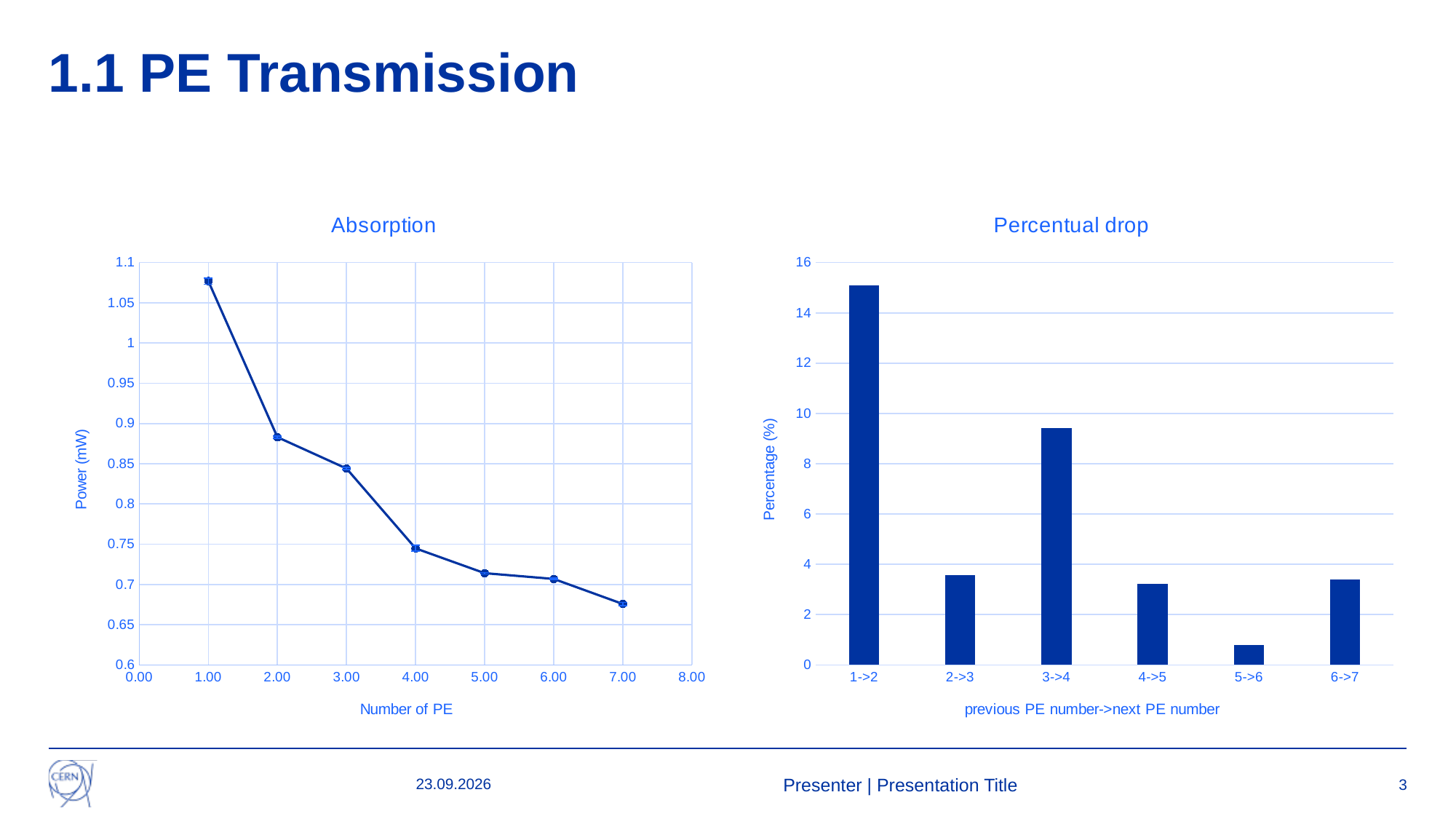
In the "Absorption" chart, is the power at 7.00 PE greater or less than 0.7? less In the "Percentual drop" chart, which category has the highest percentage? 1->2 In the "Absorption" chart, is the power at 2.00 PE greater or less than 0.9? less In the "Absorption" chart, how many data points are plotted? 7 In the "Percentual drop" chart, which is larger, the value for 2->3 or the value for 3->4? 3->4 What kind of chart is the "Absorption" chart? line chart In the "Percentual drop" chart, how many bars are there? 6 In the "Percentual drop" chart, which category has the lowest percentage? 5->6 What kind of chart is the "Percentual drop" chart? bar chart In the "Absorption" chart, do the values rise or fall as the number of PE increases? fall In the "Percentual drop" chart, is the value for 3->4 greater or less than 10? less In the "Absorption" chart, at which number of PE is the power highest? 1.00